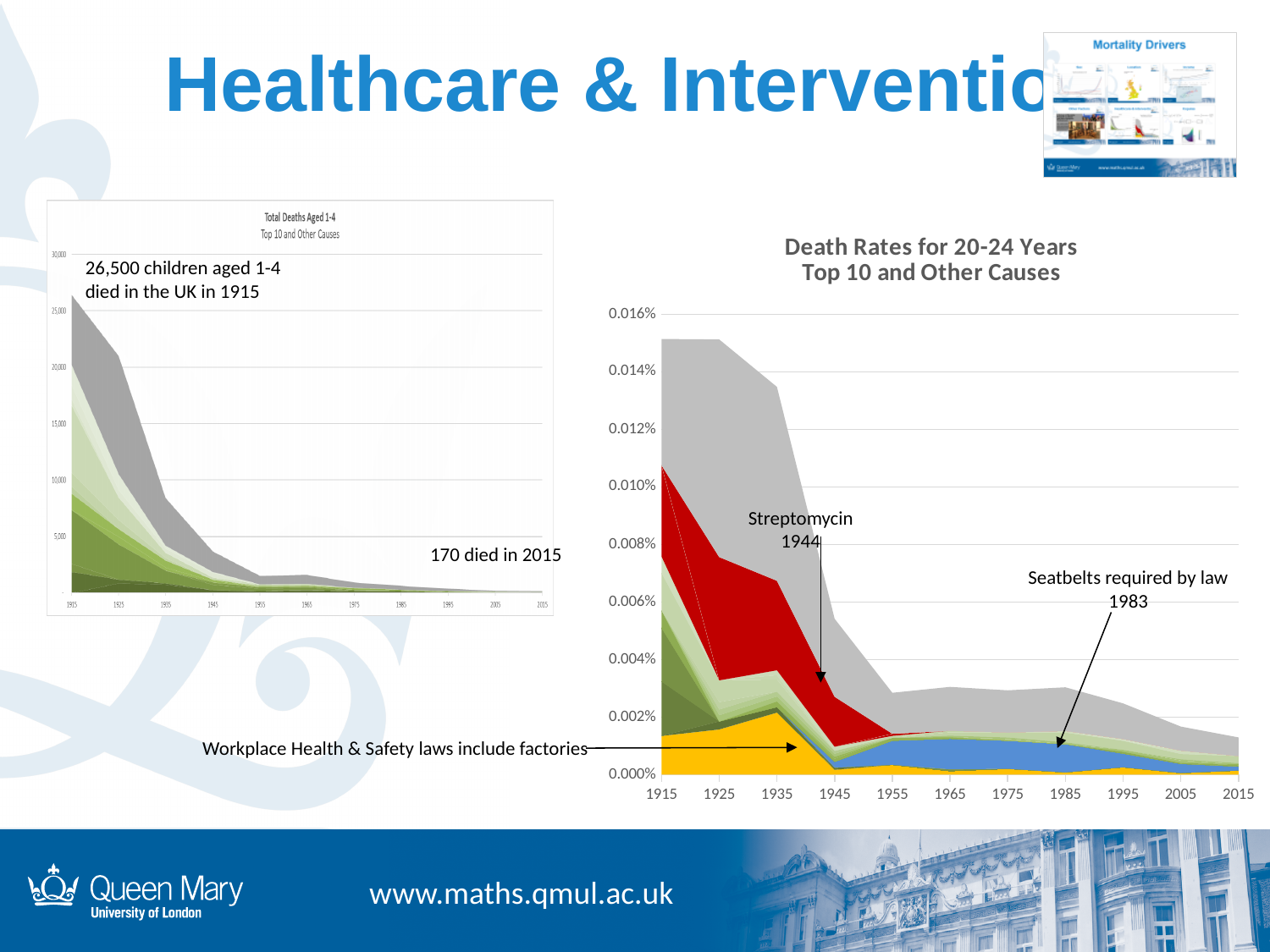
What kind of chart is the 'Death Rates for 20-24 Years' chart on the right? stacked area chart In the 'Total Deaths Aged 1-4' chart, is the total number of deaths in 1935 greater or less than 15,000? less In the 'Total Deaths Aged 1-4' chart, what is the difference between the deaths in 1915 (26,500) and in 2015 (170)? 26,330 What is the title of the chart on the left of the slide? Total Deaths Aged 1-4 Top 10 and Other Causes In the 'Death Rates for 20-24 Years' chart, is the total death rate in 1915 greater or less than 0.012%? greater In the 'Total Deaths Aged 1-4' chart, how many children aged 1-4 died in the UK in 1915 according to the annotation? 26,500 In the 'Death Rates for 20-24 Years' chart, in which year is the Streptomycin annotation placed? 1944 How many year labels are shown on the x axis of the 'Death Rates for 20-24 Years' chart? 11 In the 'Death Rates for 20-24 Years' chart, do the total death rates rise or fall from 1915 to 2015? fall In the 'Death Rates for 20-24 Years' chart, is the total death rate in 2015 greater or less than 0.002%? less In the 'Total Deaths Aged 1-4' chart, which year has more total deaths, 1915 or 2015? 1915 In the 'Total Deaths Aged 1-4' chart, how many died in 2015 according to the annotation? 170